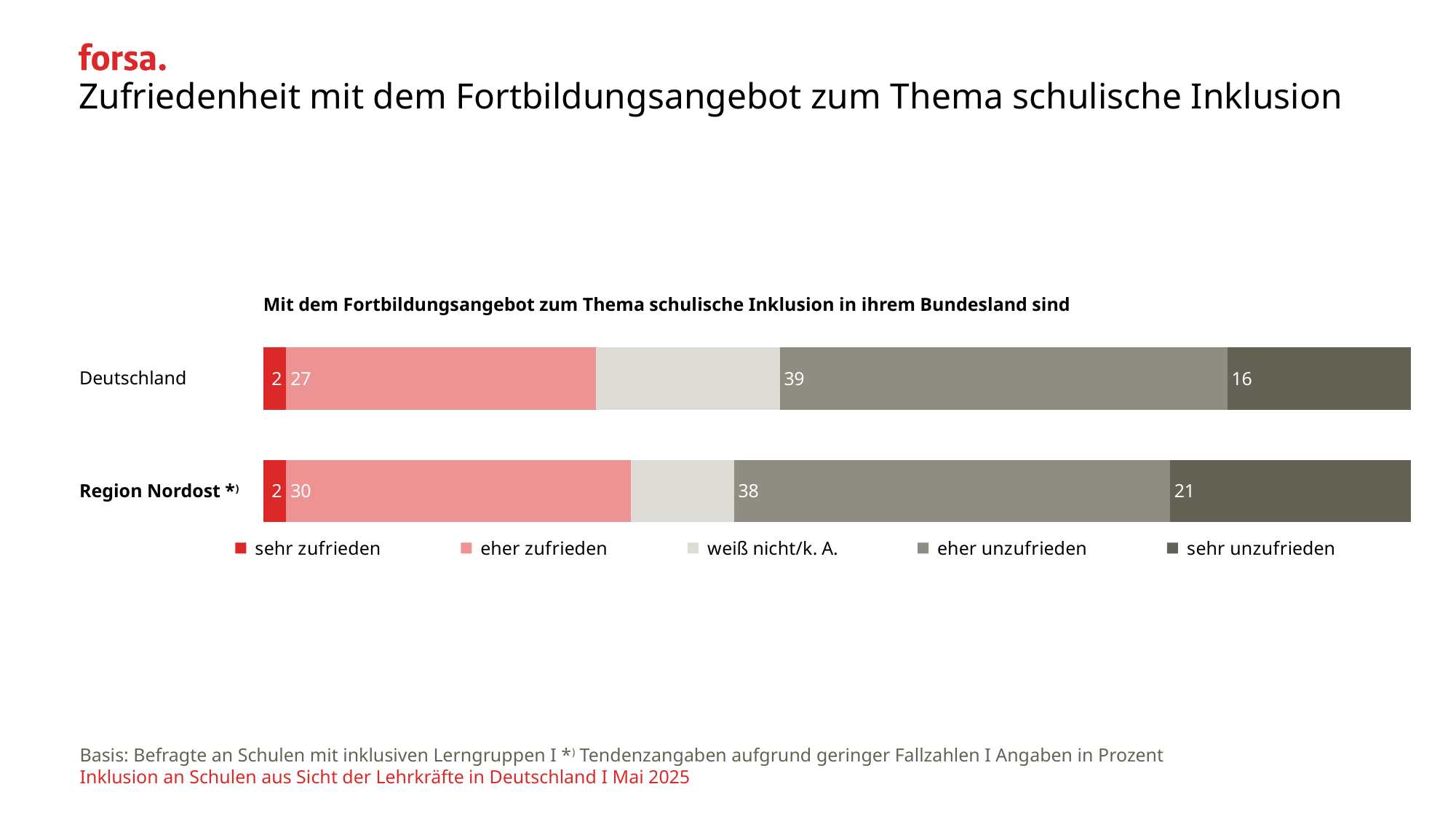
What is the value for "eher unzufrieden" for Region Nordost? 38 What is the difference between the "eher zufrieden" values for Region Nordost and Deutschland? 3 What kind of chart is shown on the slide? Stacked bar chart How many series does the legend list? 5 How many categories (bars) are shown in the chart? 2 What is the value for "eher zufrieden" for Region Nordost? 30 Which has the larger "sehr unzufrieden" value, Deutschland or Region Nordost? Region Nordost What is the value for "sehr zufrieden" for Region Nordost? 2 What is the value for "sehr unzufrieden" for Deutschland? 16 What is the value for "eher zufrieden" for Deutschland? 27 Which legend entry is shown in the lightest grey colour? weiß nicht/k. A. What is the difference between the "sehr unzufrieden" values for Region Nordost and Deutschland? 5